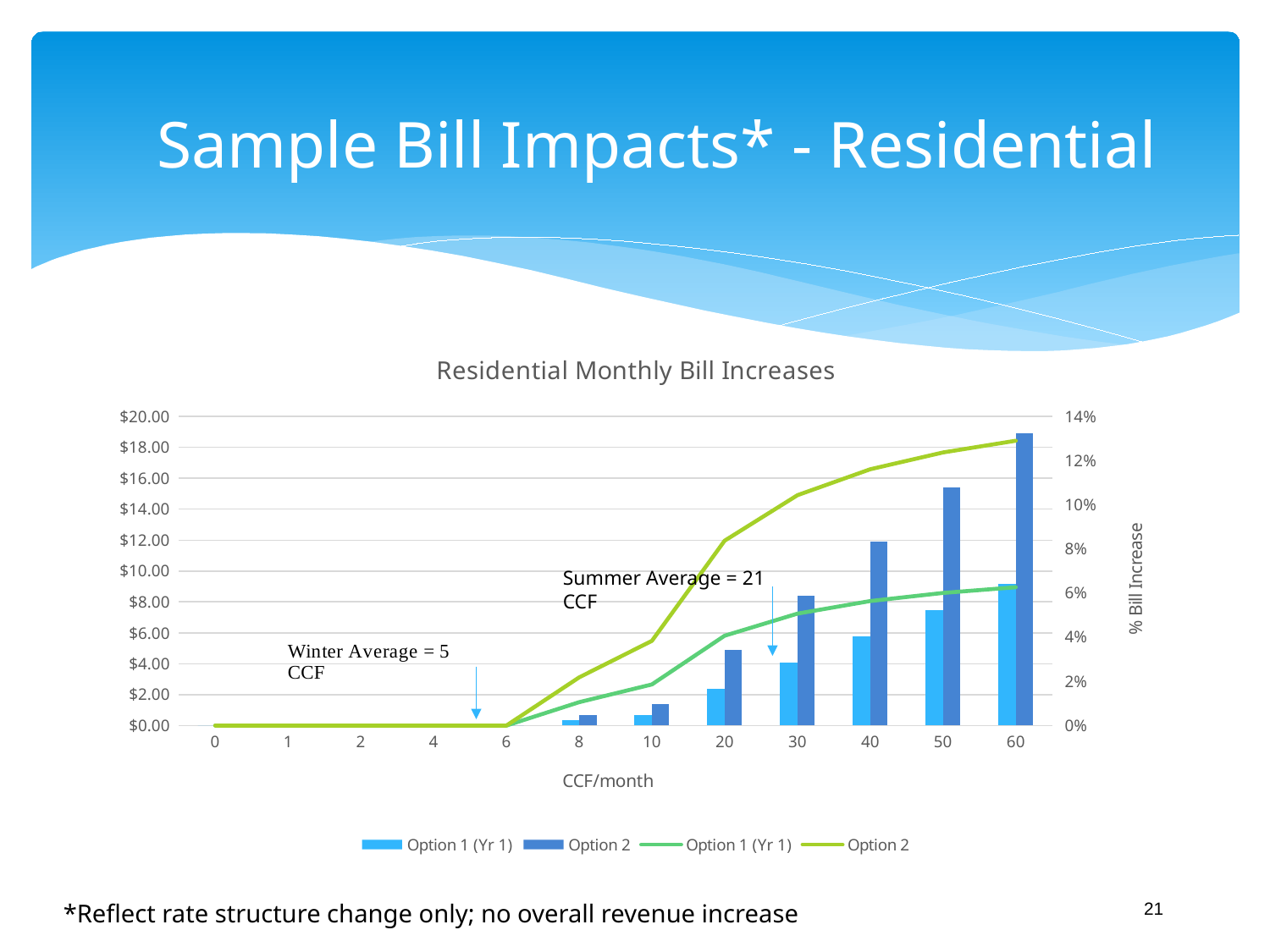
How many series does the chart legend list? 4 Is the Option 2 bar at 60 CCF/month greater or less than $18.00? greater What is the x-axis title of the chart? CCF/month At which CCF/month category is the Option 2 bar highest? 60 How many categories are shown on the x axis of the chart? 12 Is the Option 1 (Yr 1) bar at 60 CCF/month greater or less than $8.00? greater At 60 CCF/month, which bar is taller: Option 1 (Yr 1) or Option 2? Option 2 What is the title of the chart? Residential Monthly Bill Increases Is the Option 2 line at 60 CCF/month greater or less than 12% on the % Bill Increase axis? greater Do the Option 2 bars rise or fall as CCF/month increases from 20 to 60? rise